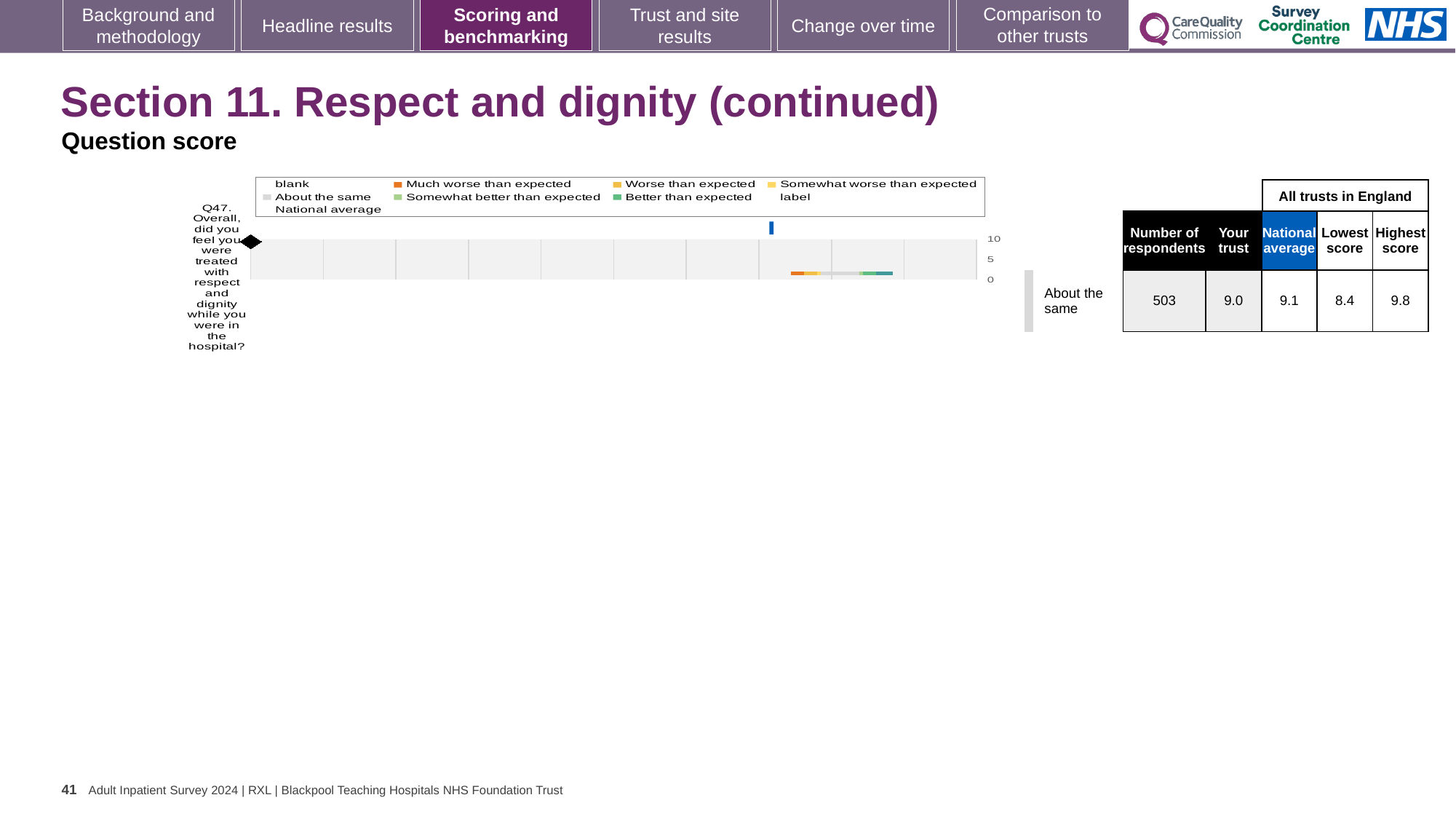
Which is larger for Q47, the 'Your trust' score or the National average? National average What benchmarking category is given for Q47 next to the chart? About the same How many questions are plotted on the chart? 1 What is the highest value shown on the chart's axis? 10 What is the National average score for Q47 shown in the table next to the chart? 9.1 What is the Lowest score among all trusts in England for Q47? 8.4 How many respondents answered Q47? 503 What is the 'Your trust' score for Q47 shown in the table next to the chart? 9.0 What is the difference between the National average and the 'Your trust' score for Q47? 0.1 What kind of chart is used to show the Q47 question score? bar chart What is the difference between the Highest score and the Lowest score for Q47? 1.4 What is the Highest score among all trusts in England for Q47? 9.8